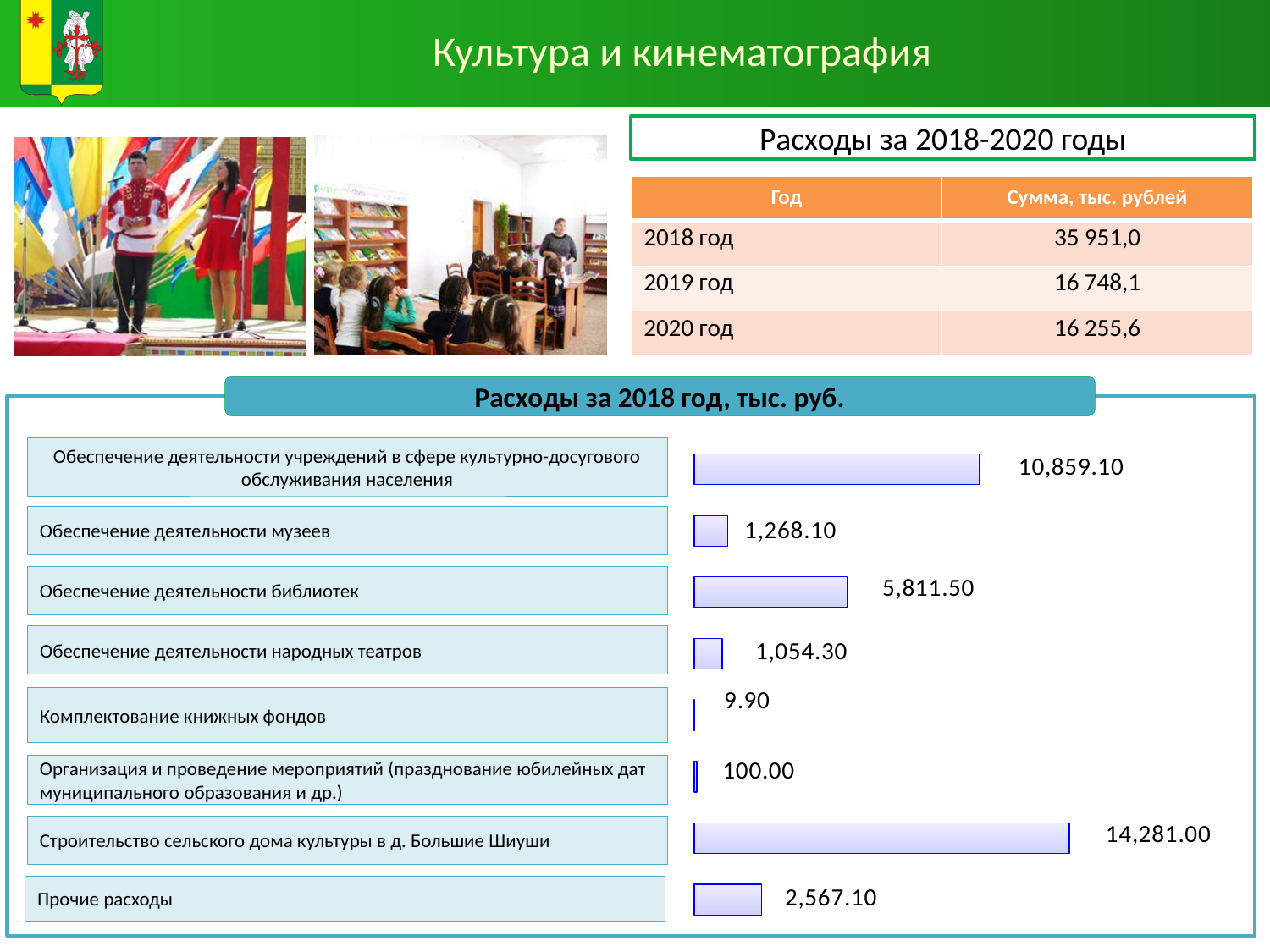
What is the value for «Обеспечение деятельности музеев» in the chart «Расходы за 2018 год, тыс. руб.»? 1,268.10 What is the value for «Обеспечение деятельности библиотек» in the chart «Расходы за 2018 год, тыс. руб.»? 5,811.50 How many categories are shown in the chart «Расходы за 2018 год, тыс. руб.»? 8 In the chart «Расходы за 2018 год, тыс. руб.», what is the difference between «Прочие расходы» and «Обеспечение деятельности музеев»? 1,299.00 What is the title of the chart at the bottom of the slide? Расходы за 2018 год, тыс. руб. In the chart «Расходы за 2018 год, тыс. руб.», what is the difference between «Строительство сельского дома культуры в д. Большие Шиуши» and «Обеспечение деятельности учреждений в сфере культурно-досугового обслуживания населения»? 3,421.90 In the chart «Расходы за 2018 год, тыс. руб.», which is larger: «Обеспечение деятельности музеев» or «Обеспечение деятельности народных театров»? Обеспечение деятельности музеев What kind of chart is «Расходы за 2018 год, тыс. руб.»? Bar chart Which category has the lowest value in the chart «Расходы за 2018 год, тыс. руб.»? Комплектование книжных фондов What is the value for «Комплектование книжных фондов» in the chart «Расходы за 2018 год, тыс. руб.»? 9.90 What is the value for «Строительство сельского дома культуры в д. Большие Шиуши» in the chart «Расходы за 2018 год, тыс. руб.»? 14,281.00 Which category has the highest value in the chart «Расходы за 2018 год, тыс. руб.»? Строительство сельского дома культуры в д. Большие Шиуши